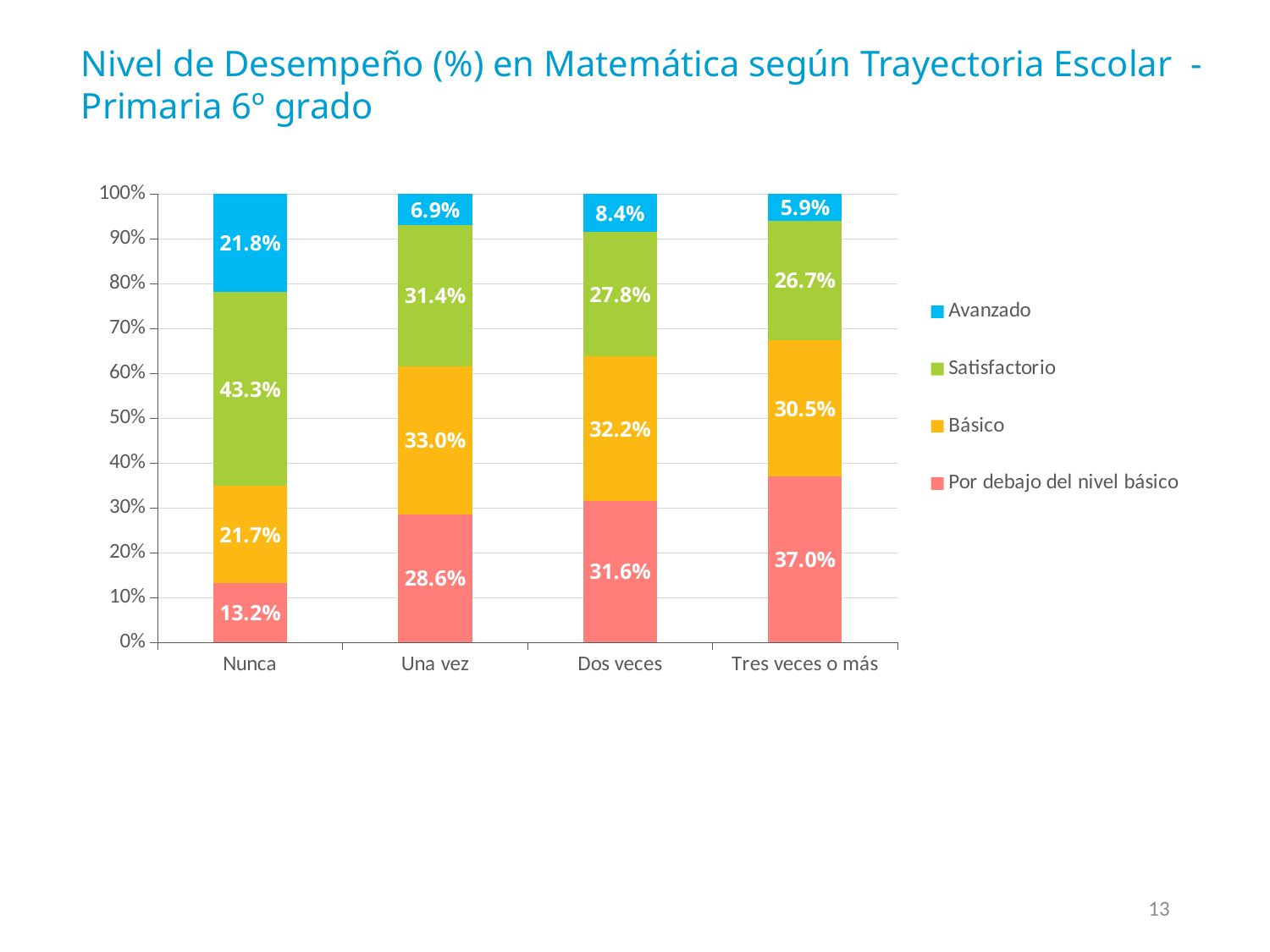
How many series does the legend list? 4 Which category has the lowest Avanzado value? Tres veces o más How many categories are shown on the x axis? 4 What is the value of Por debajo del nivel básico for Tres veces o más? 37.0% What kind of chart is shown on the slide? Stacked bar chart Which is larger, the Satisfactorio value for Una vez or for Dos veces? Una vez Which category has the highest Avanzado value? Nunca What is the value of Básico for Una vez? 33.0% Does the Por debajo del nivel básico value rise or fall from Nunca to Tres veces o más? Rise What is the value of Avanzado for the Nunca category? 21.8% What is the total of the stacked bar for Nunca? 100.0% What is the difference between the Satisfactorio values for Nunca and Tres veces o más? 16.6 percentage points